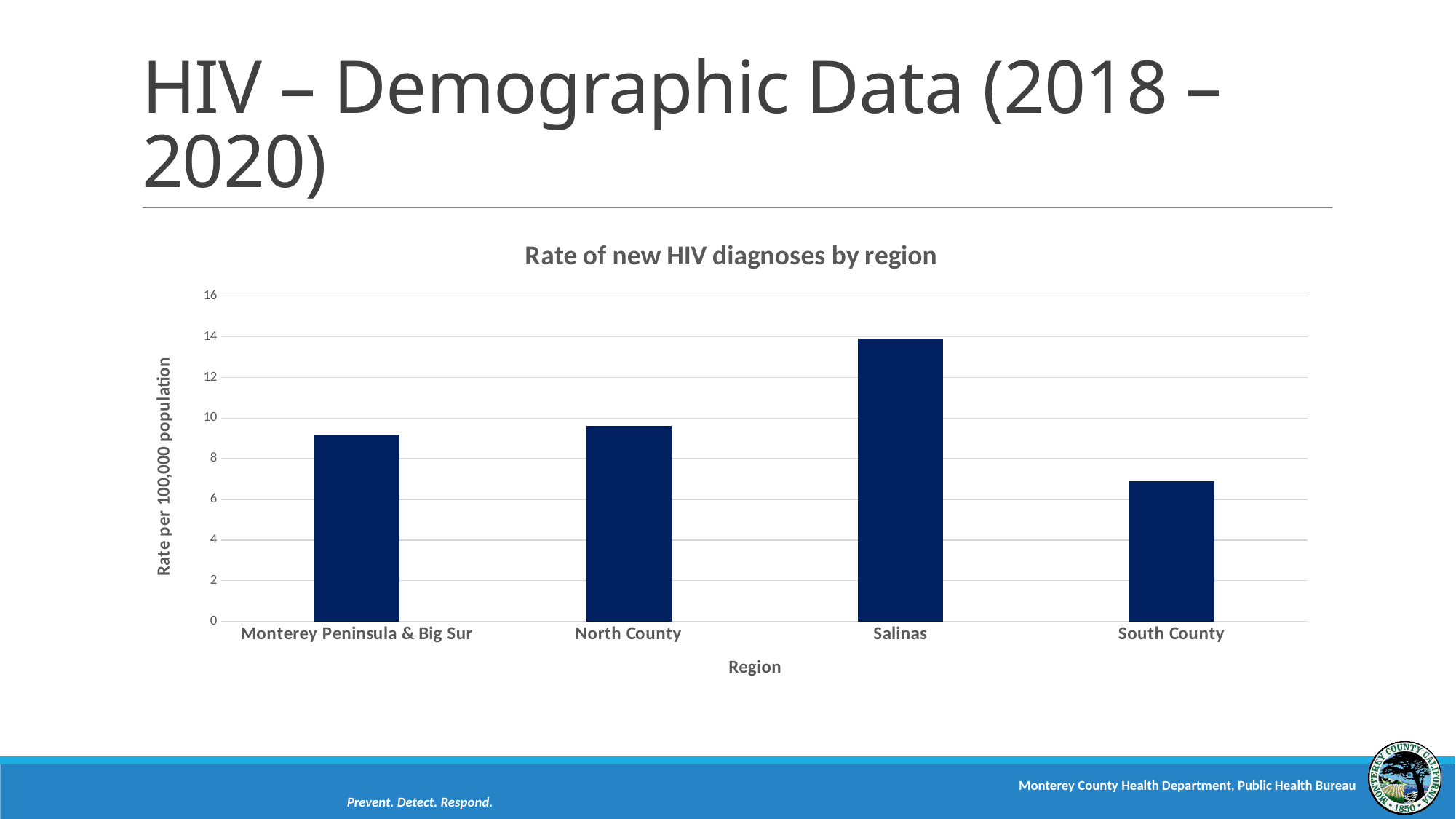
Which region has the lowest rate of new HIV diagnoses? South County What kind of chart is shown on the slide? bar chart Which is larger, the value for South County or the value for Monterey Peninsula & Big Sur? Monterey Peninsula & Big Sur Is the value for Salinas greater or less than 12? greater Is the value for North County greater or less than 8? greater Which is larger, the value for Salinas or the value for North County? Salinas Which region has the highest rate of new HIV diagnoses? Salinas What is the label of the y axis of the chart? Rate per 100,000 population Is the value for South County greater or less than 8? less How many regions are shown on the x axis of the chart? 4 What is the title of the chart? Rate of new HIV diagnoses by region